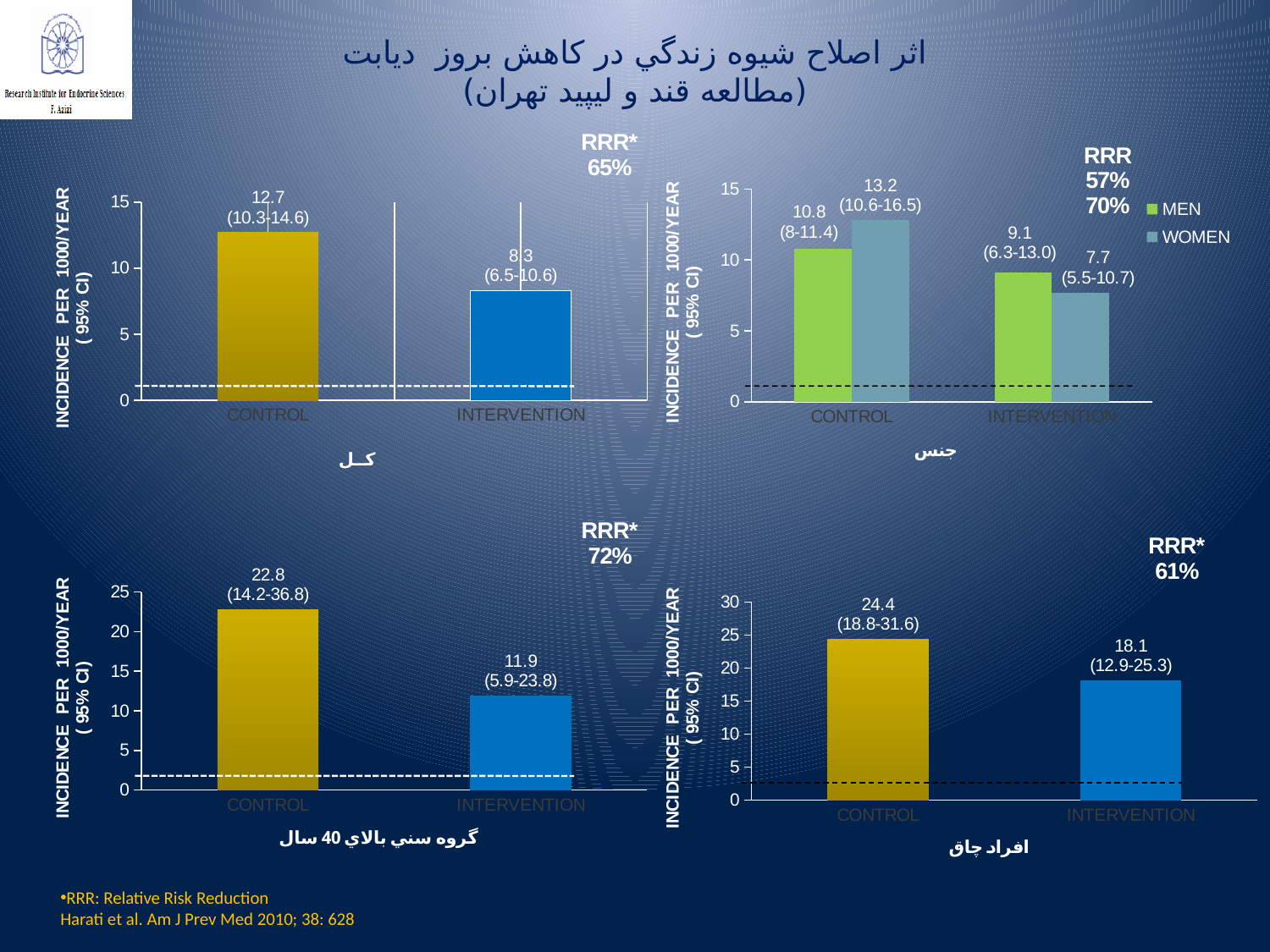
In the bottom-left chart, what is the 95% CI shown for INTERVENTION? (5.9-23.8) In the bottom-right chart, what is the incidence per 1000/year for INTERVENTION? 18.1 In the top-left chart, what is the incidence per 1000/year for INTERVENTION? 8.3 In the bottom-right chart, which category has the highest value? CONTROL In the top-right chart, how many series does the legend list? 2 In the top-right chart, what is the value for MEN in the INTERVENTION group? 9.1 In the top-left chart, what is the incidence per 1000/year for CONTROL? 12.7 In the top-left chart, what is the difference between the CONTROL and INTERVENTION values? 4.4 In the top-right chart, what is the value for WOMEN in the CONTROL group? 13.2 What kind of chart is the bottom-right chart? Bar chart In the bottom-left chart, what is the incidence per 1000/year for CONTROL? 22.8 In the top-right chart, which is larger in the INTERVENTION group, MEN or WOMEN? MEN